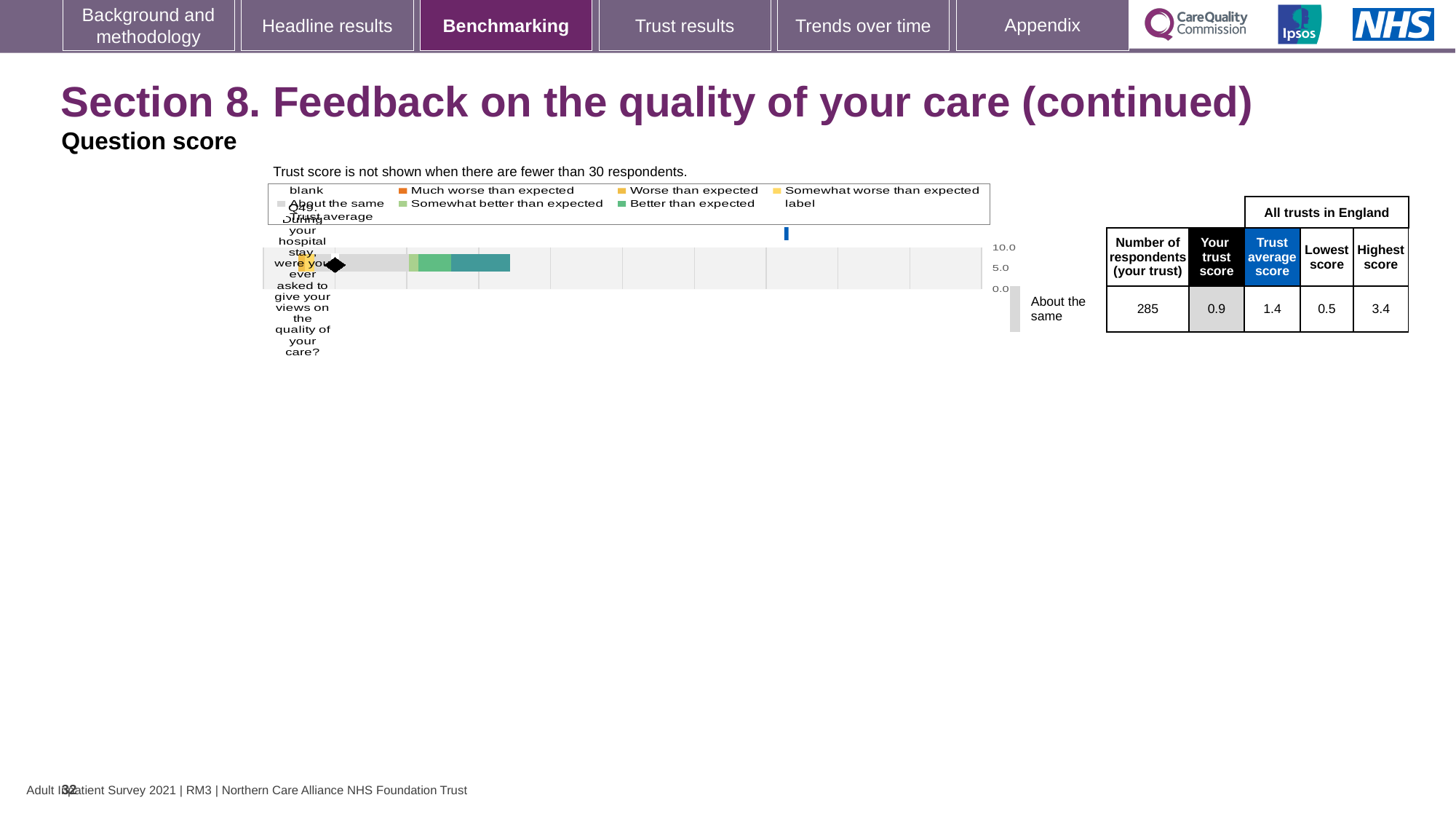
In the table next to the chart, what is the number of respondents for your trust for Q49? 285 In the table next to the chart, what is your trust score for Q49? 0.9 In the table next to the chart, what is the trust average score for Q49? 1.4 What kind of chart is shown on the slide? bar chart According to the note above the chart, the trust score is not shown when there are fewer than how many respondents? 30 Which is larger for Q49: your trust score or the trust average score? trust average score What is the difference between the highest score and the lowest score for Q49 in the table? 2.9 What benchmark rating is shown to the right of the bar chart for Q49? About the same In the table next to the chart, what is the highest score among all trusts in England for Q49? 3.4 In the table next to the chart, what is the lowest score among all trusts in England for Q49? 0.5 Which question number is plotted in the bar chart? Q49 How many questions (categories) are plotted in the bar chart? 1